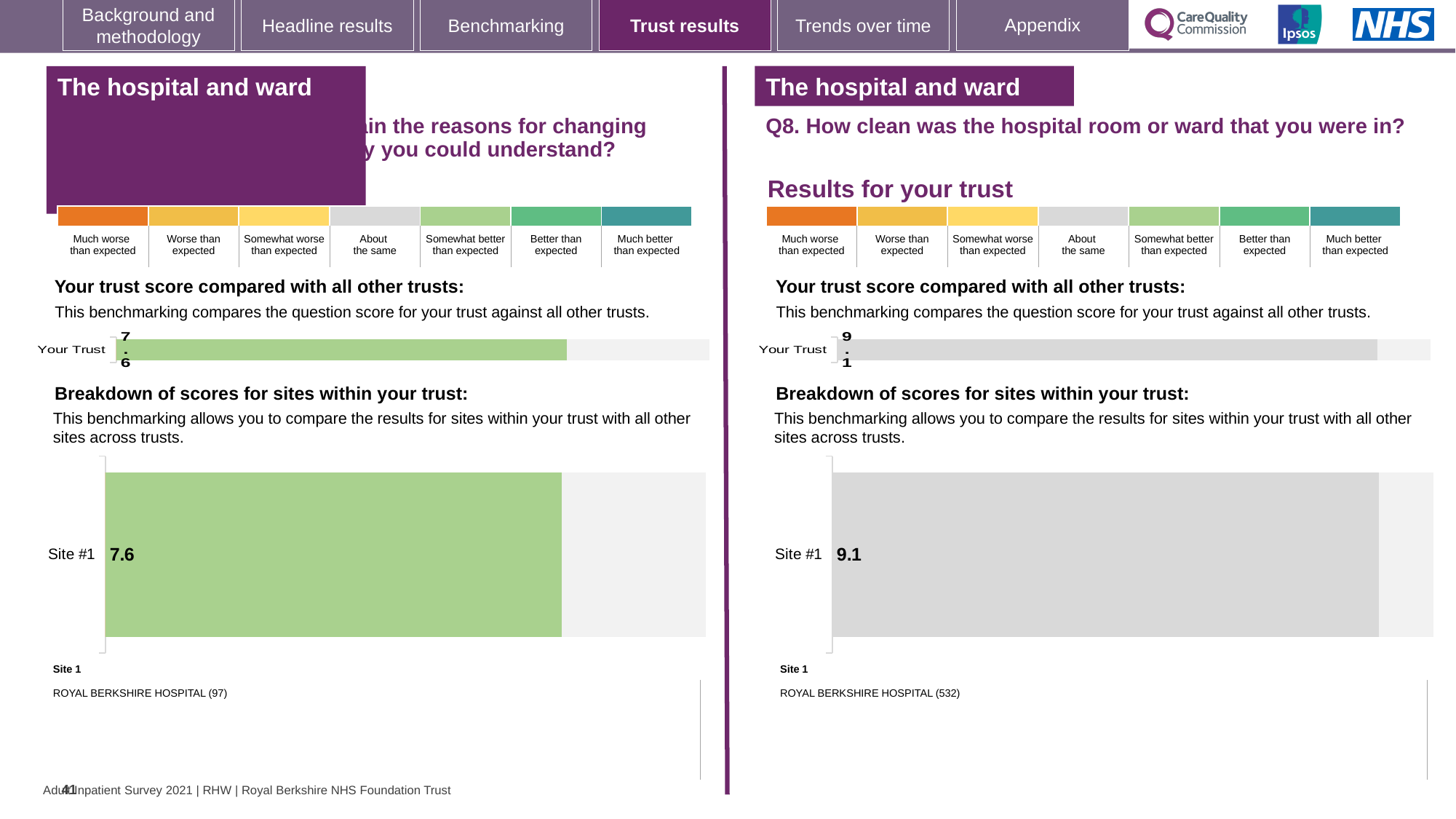
What type of chart is used for the Site #1 breakdown on the right-hand side (Q8)? Bar chart On the left-hand breakdown chart, which site name is listed as Site 1? ROYAL BERKSHIRE HOSPITAL (97) What is the difference between the Your Trust score on the right-hand Q8 chart and the Your Trust score on the left-hand chart? 1.5 On the right-hand Q8 breakdown chart, which site name is listed as Site 1? ROYAL BERKSHIRE HOSPITAL (532) On the left-hand breakdown of scores for sites chart, what is the score for Site #1? 7.6 Which is larger: the Site #1 score on the left-hand breakdown chart or the Site #1 score on the right-hand breakdown chart (Q8)? Right-hand (Q8) Site #1, 9.1 On the right-hand chart for Q8 (How clean was the hospital room or ward), what is the score shown for Your Trust? 9.1 On the right-hand breakdown of scores for sites chart (Q8), what is the score for Site #1? 9.1 How many sites are shown in the right-hand breakdown of scores for sites chart (Q8)? 1 How many sites are shown in the left-hand breakdown of scores for sites chart? 1 On the left-hand 'Your trust score compared with all other trusts' chart, what is the score shown for Your Trust? 7.6 Is the Your Trust score on the right-hand Q8 chart greater or less than 9? greater